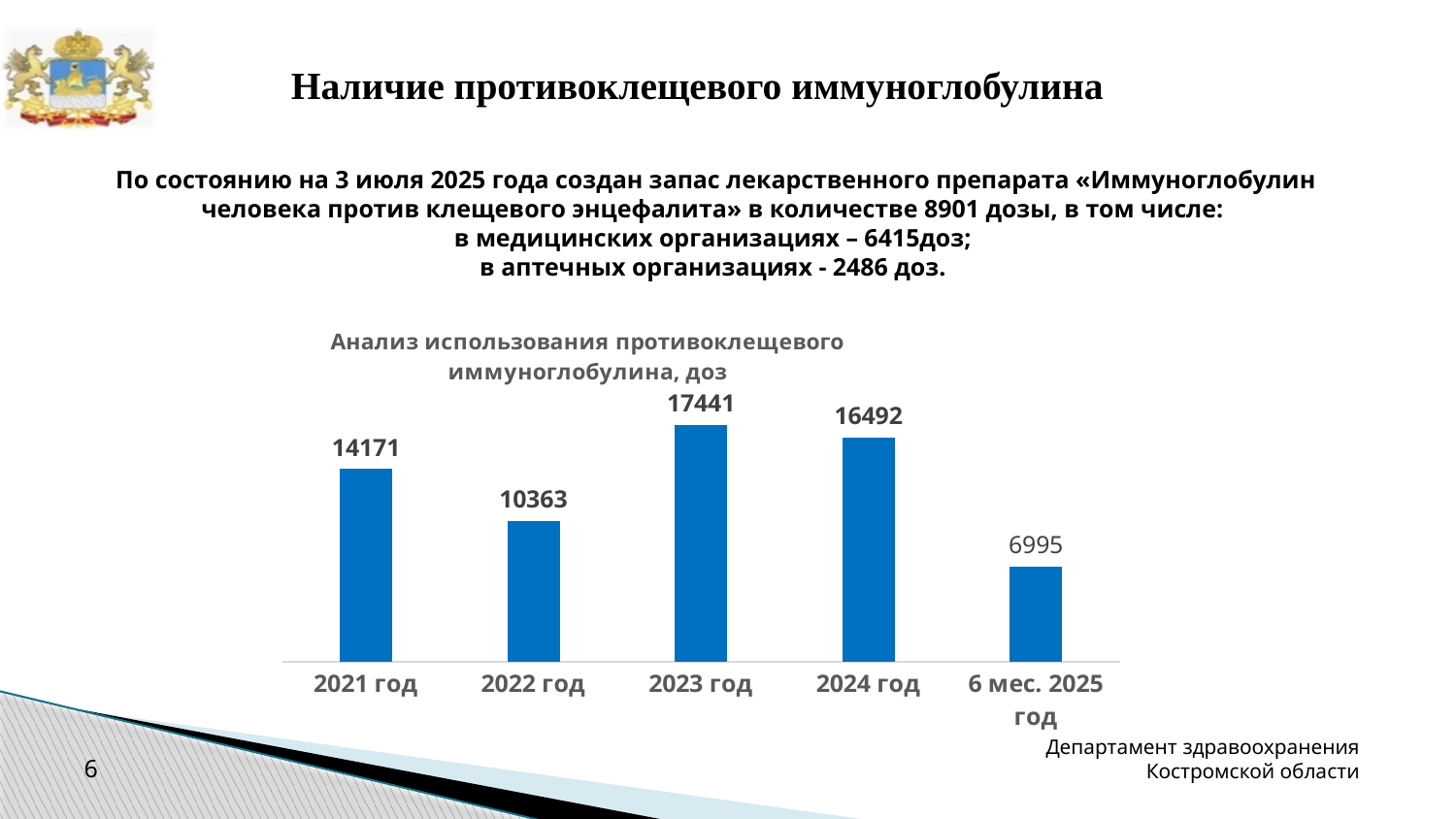
Does the value rise or fall from 2021 год to 2022 год? fall What is the value for 2023 год? 17441 Which category has the lowest value? 6 мес. 2025 год Which is larger, the value for 2021 год or the value for 2024 год? 2024 год What is the title of the chart? Анализ использования противоклещевого иммуноглобулина, доз What is the difference between the values for 2021 год and 2022 год? 3808 What kind of chart is shown on the slide? bar chart Which category has the highest value? 2023 год What is the value for 2022 год? 10363 What is the difference between the values for 2023 год and 2024 год? 949 What is the value for 6 мес. 2025 год? 6995 How many categories are shown on the x axis? 5